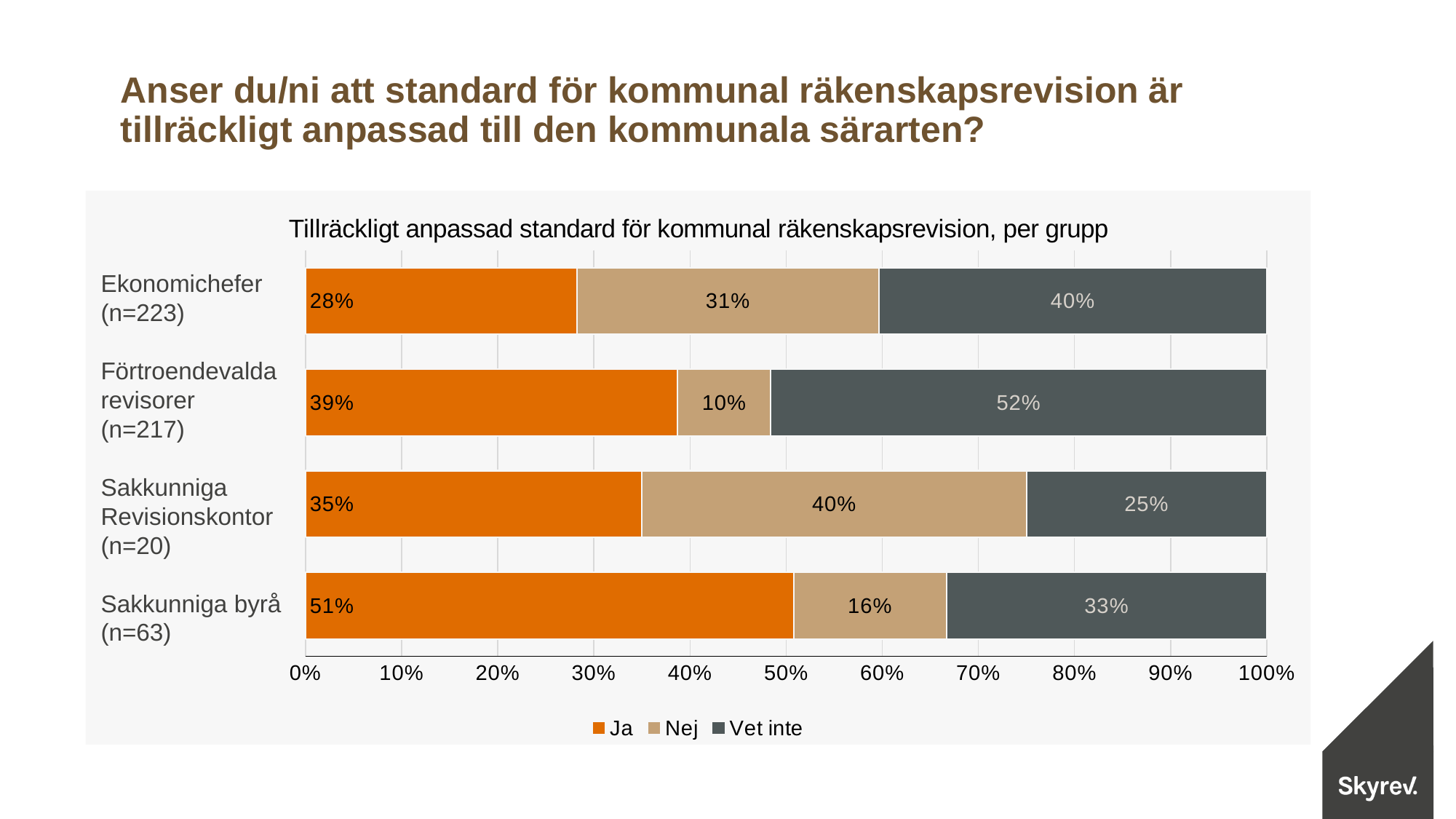
Which group has the lowest 'Nej' share? Förtroendevalda revisorer (n=217) How many series does the legend list? 3 Which series is shown in orange? Ja What is the title of the chart? Tillräckligt anpassad standard för kommunal räkenskapsrevision, per grupp How many groups are shown on the chart? 4 What is the 'Ja' value for Sakkunniga byrå (n=63)? 51% What kind of chart is shown on the slide? Stacked bar chart What is the difference between the 'Vet inte' values for Förtroendevalda revisorer (n=217) and Sakkunniga Revisionskontor (n=20)? 27% What is the 'Vet inte' value for Förtroendevalda revisorer (n=217)? 52% Which is larger: the 'Ja' value for Ekonomichefer (n=223) or the 'Ja' value for Sakkunniga Revisionskontor (n=20)? Sakkunniga Revisionskontor (n=20) Which group has the highest 'Ja' share? Sakkunniga byrå (n=63) What is the 'Nej' value for Sakkunniga Revisionskontor (n=20)? 40%